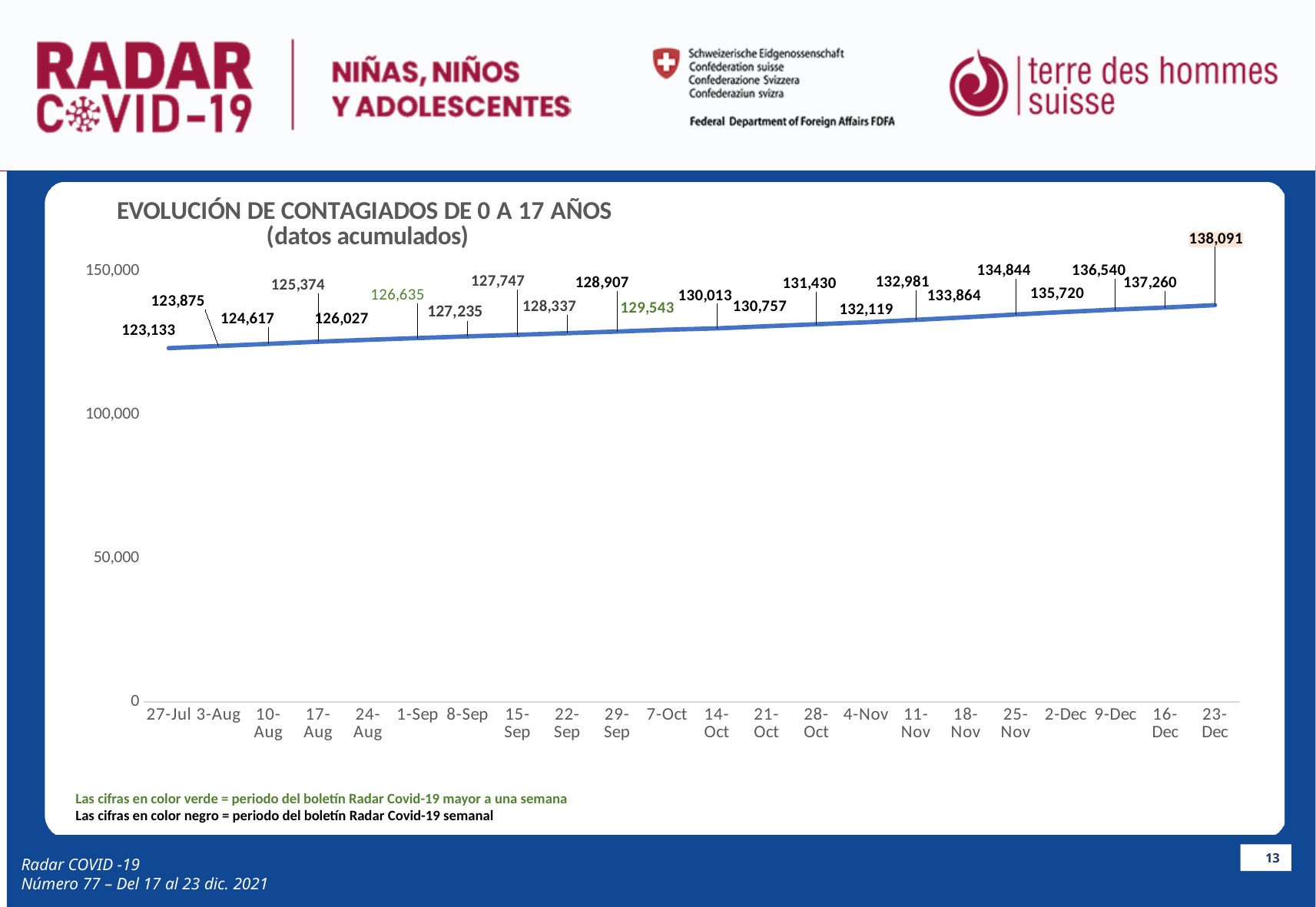
What value is labelled for 18-Nov? 133,864 Do the values rise or fall from 27-Jul to 23-Dec? rise Which date has the highest cumulative value? 23-Dec What value is labelled for 7-Oct? 129,543 Is the value for 27-Jul greater or less than 100,000? greater What is the cumulative value shown for 27-Jul? 123,133 What is the cumulative value shown for 23-Dec? 138,091 Which date has the lowest cumulative value? 27-Jul How many dates are shown on the x axis? 22 What is the difference between the values for 23-Dec and 16-Dec? 831 What is the difference between the values for 23-Dec and 27-Jul? 14,958 Which is larger, the value for 14-Oct or the value for 4-Nov? 4-Nov